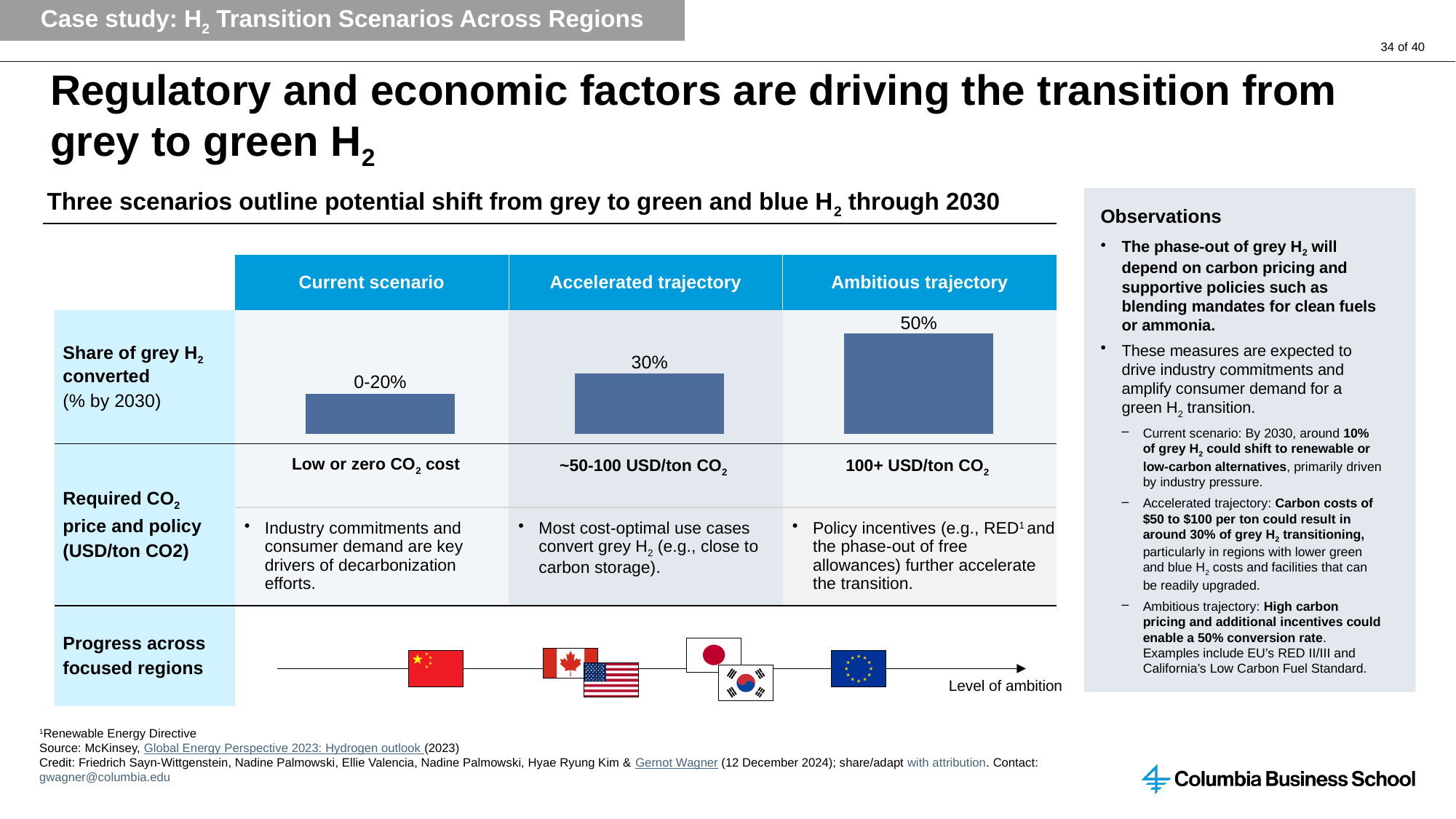
Do the bars for share of grey H2 converted rise or fall from the Current scenario to the Ambitious trajectory? Rise How many scenarios are shown as bars in the share of grey H2 converted chart? 3 Which scenario has the lowest share of grey H2 converted by 2030? Current scenario What is the required CO2 price shown for the Accelerated trajectory? ~50-100 USD/ton CO2 What kind of chart shows the share of grey H2 converted by 2030? Bar chart Which has a larger share of grey H2 converted by 2030, the Accelerated trajectory or the Ambitious trajectory? Ambitious trajectory What share of grey H2 converted by 2030 is shown for the Current scenario? 0-20% What is the difference in share of grey H2 converted between the Ambitious trajectory and the Accelerated trajectory? 20 percentage points Which scenario has the highest share of grey H2 converted by 2030? Ambitious trajectory What share of grey H2 converted by 2030 is shown for the Accelerated trajectory? 30% What is the required CO2 price shown for the Ambitious trajectory? 100+ USD/ton CO2 What share of grey H2 converted by 2030 is shown for the Ambitious trajectory? 50%